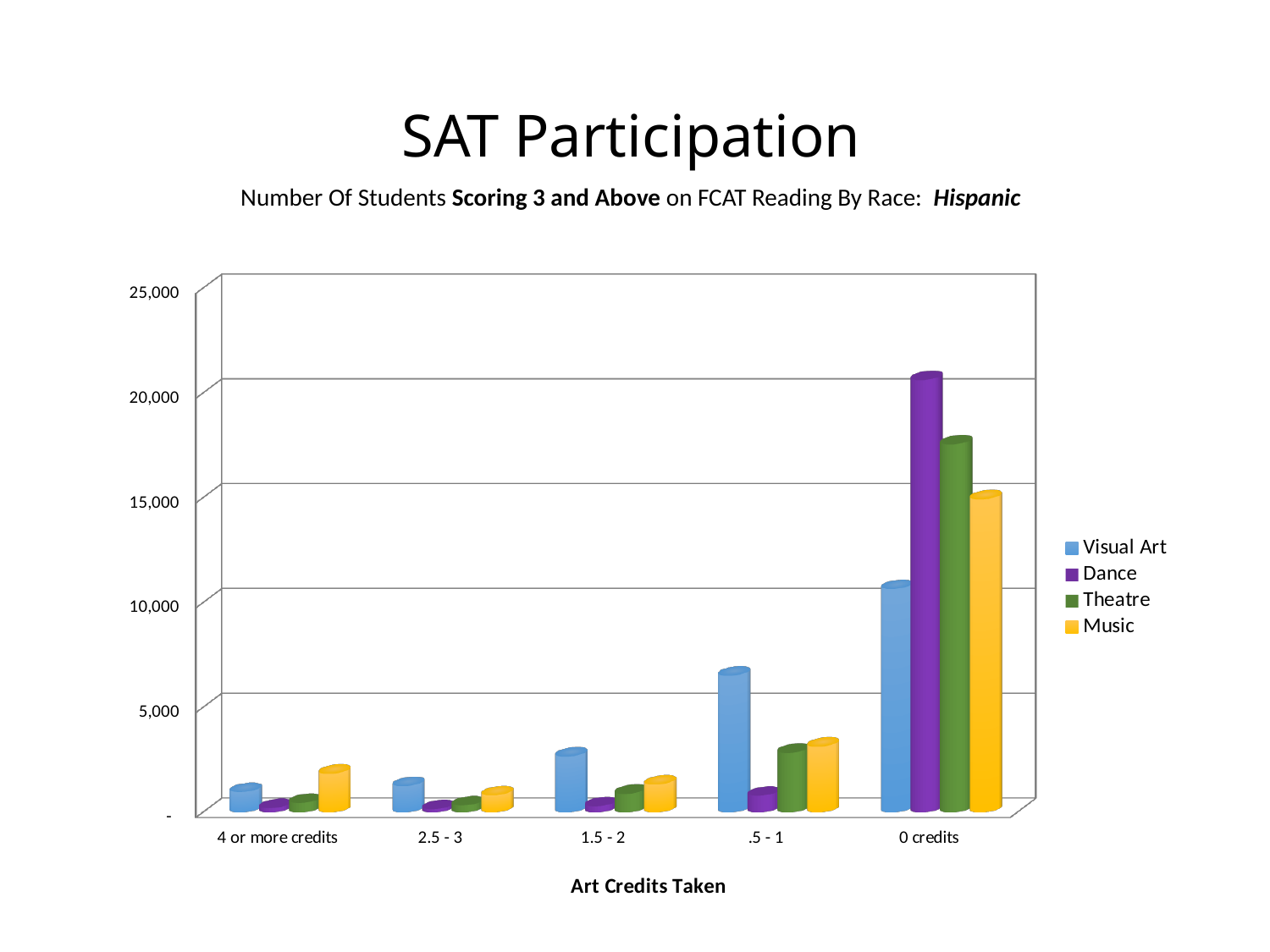
Is the value for Theatre at 0 credits greater or less than 15,000? greater What is the title of the x axis? Art Credits Taken What kind of chart is shown on the slide? bar chart For the .5 - 1 category, which is larger: Visual Art or Theatre? Visual Art For the 4 or more credits category, which is larger: Music or Visual Art? Music Which series has the highest value for the 0 credits category? Dance Which series has the lowest value for the 0 credits category? Visual Art Is the value for Visual Art at 0 credits greater or less than 15,000? less How many series does the legend list? 4 For which category is the Visual Art value highest? 0 credits How many categories are shown on the x axis? 5 Is the value for Visual Art at .5 - 1 credits greater or less than 5,000? greater